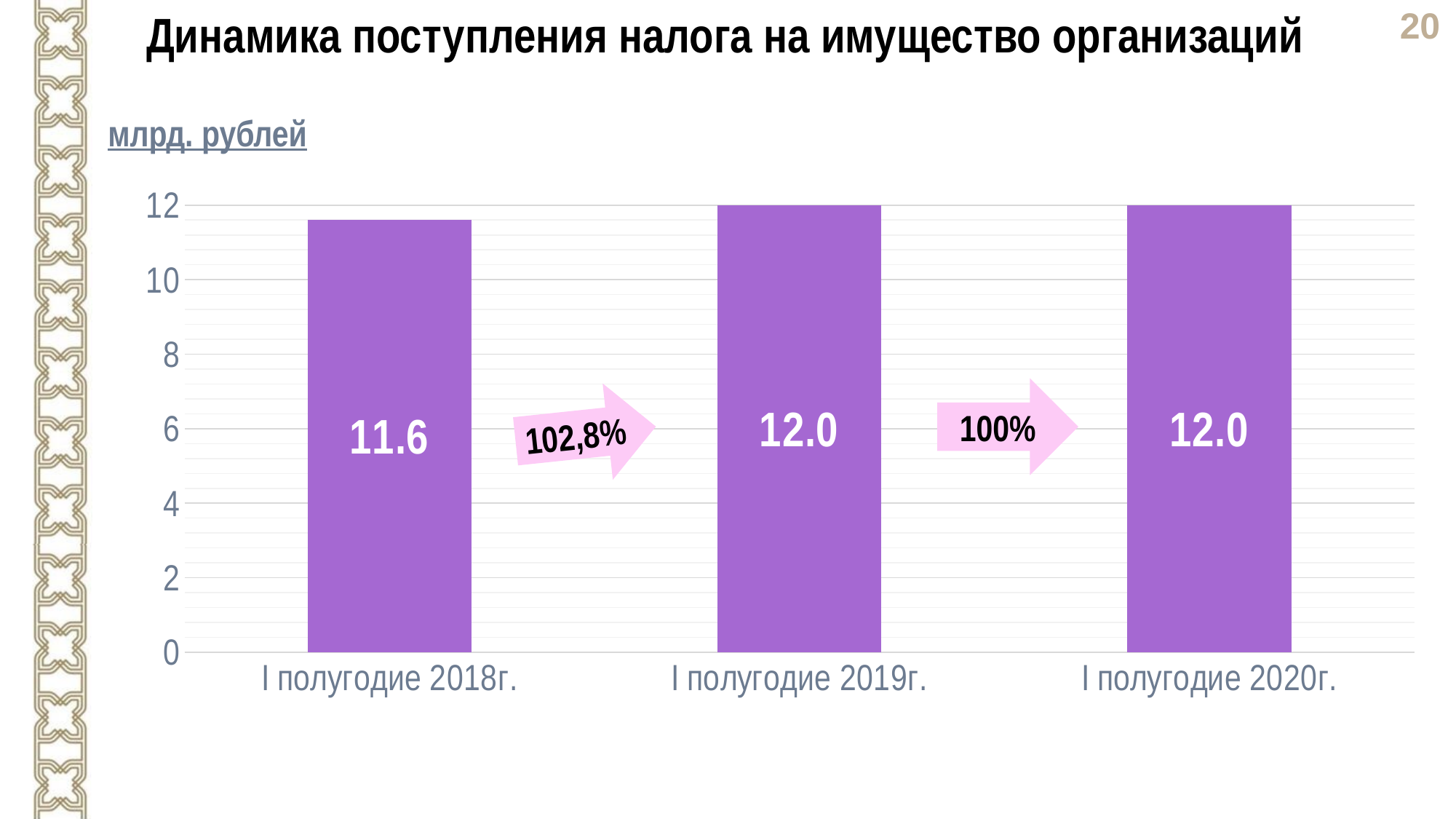
How many categories are shown on the x axis? 3 What is the difference between the values for I полугодие 2019г. and I полугодие 2018г.? 0.4 What kind of chart is shown on the slide? bar chart What is the value for I полугодие 2018г.? 11.6 What is the value for I полугодие 2020г.? 12.0 What is the value for I полугодие 2019г.? 12.0 Is the value for I полугодие 2018г. greater or less than 10? greater Which is larger, the value for I полугодие 2018г. or the value for I полугодие 2019г.? I полугодие 2019г. Which category has the lowest value? I полугодие 2018г. What unit is stated above the chart? млрд. рублей What percentage is shown on the arrow between I полугодие 2018г. and I полугодие 2019г.? 102,8% Do the values rise or fall from I полугодие 2018г. to I полугодие 2019г.? rise